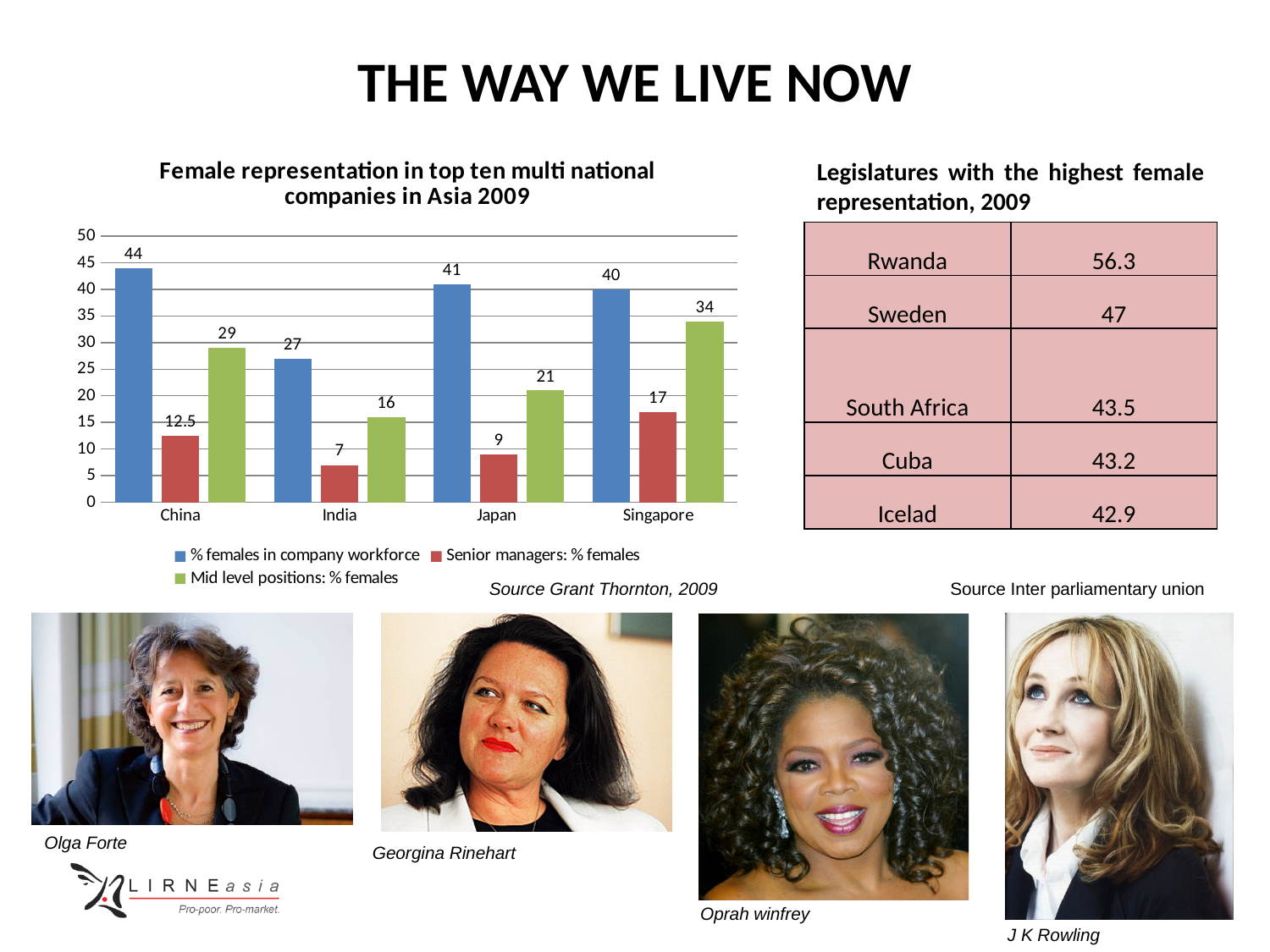
Which country has the highest value for % females in company workforce? China What is the value for Senior managers: % females in India? 7 What is the difference between Mid level positions: % females in Singapore and in India? 18 What is the value for % females in company workforce in China? 44 Which is larger: Senior managers: % females in Japan or in Singapore? Singapore What is the value for Senior managers: % females in China? 12.5 Which country has the lowest value for Senior managers: % females? India What is the value for Mid level positions: % females in Singapore? 34 How many series does the chart's legend list? 3 What type of chart is used to show female representation in top ten multi national companies in Asia 2009? Bar chart Is the value for % females in company workforce in India greater or less than 30? less How many countries are shown on the x axis of the chart? 4